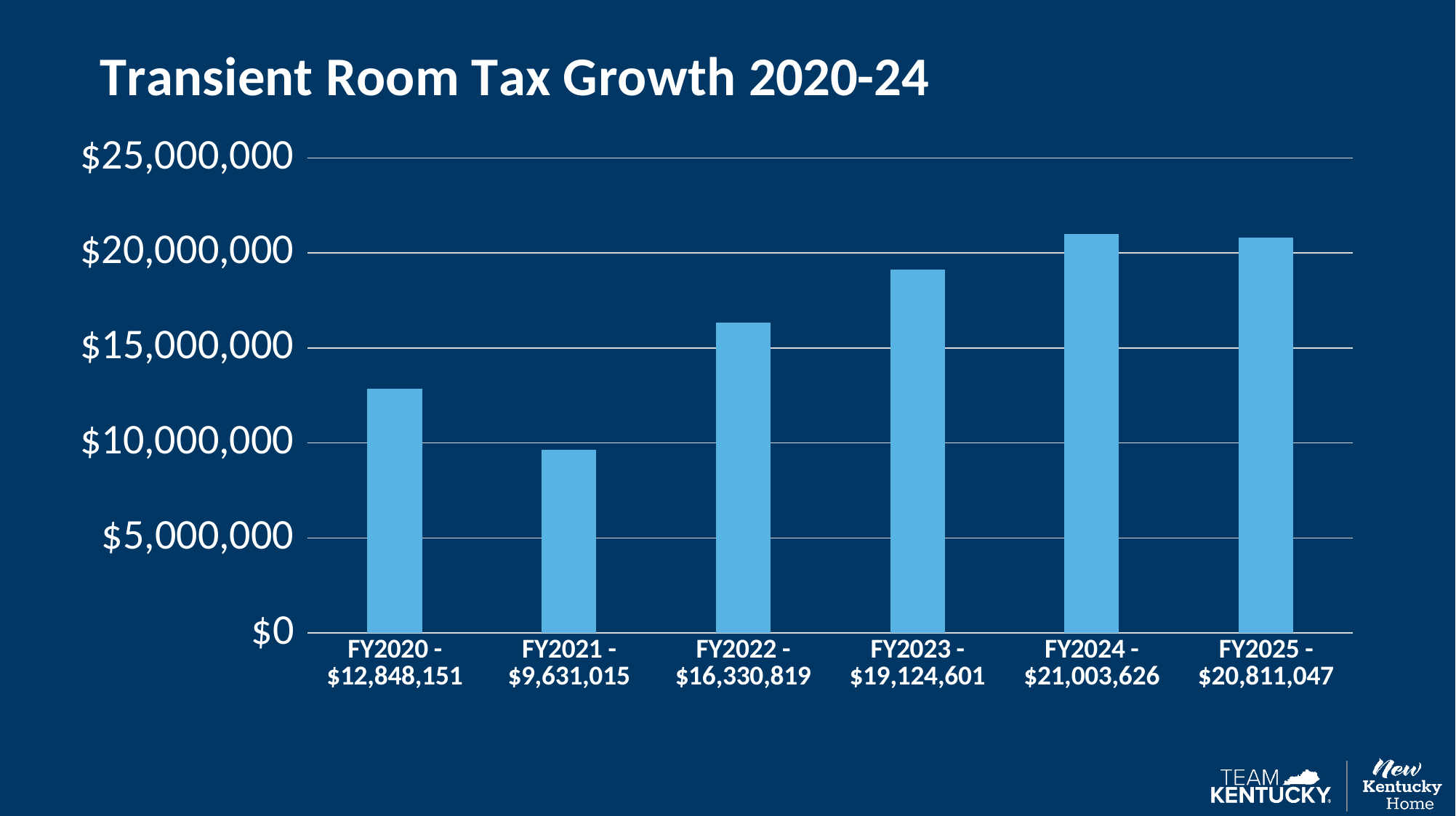
What kind of chart is shown on the slide? bar chart Is the value for FY2023 greater or less than $20,000,000? less How many fiscal years are shown in the chart? 6 Which fiscal year has the highest transient room tax value? FY2024 What is the transient room tax value for FY2023? $19,124,601 What is the title of the chart? Transient Room Tax Growth 2020-24 What is the difference between the FY2022 and FY2021 values? $6,699,804 What is the difference between the FY2024 and FY2025 values? $192,579 Which is larger, the value for FY2020 or the value for FY2021? FY2020 What is the transient room tax value for FY2020? $12,848,151 Which fiscal year has the lowest transient room tax value? FY2021 What is the transient room tax value for FY2025? $20,811,047